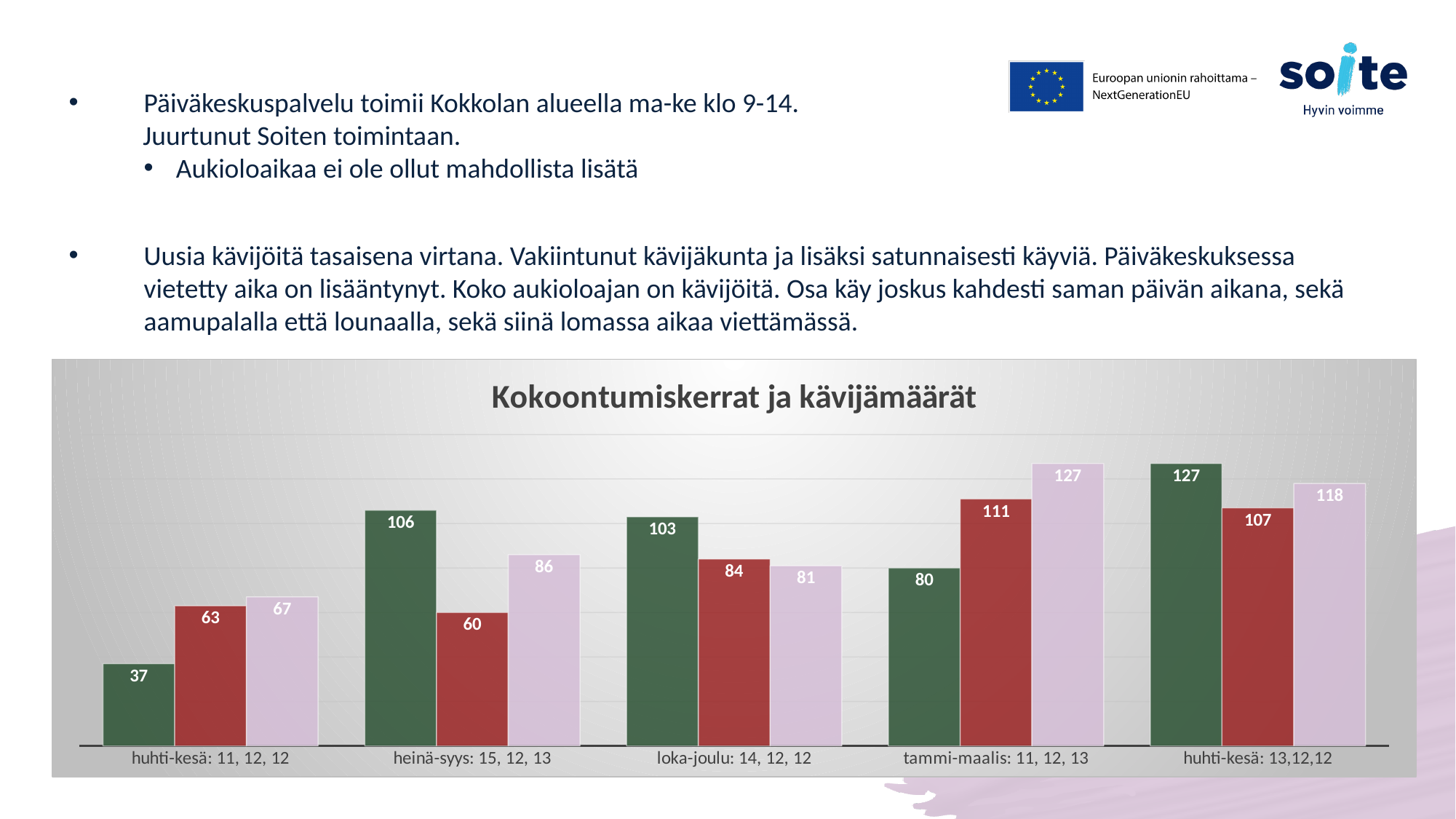
What kind of chart is shown on the slide? bar chart What is the value of the light pink bar for 'tammi-maalis: 11, 12, 13'? 127 What is the value of the red bar for 'heinä-syys: 15, 12, 13'? 60 What is the value of the green bar for 'huhti-kesä: 11, 12, 12'? 37 Do the green bar values rise or fall from 'tammi-maalis: 11, 12, 13' to 'huhti-kesä: 13,12,12'? rise Which category has the lowest green bar? huhti-kesä: 11, 12, 12 Which is larger for 'loka-joulu: 14, 12, 12', the green bar or the red bar? the green bar What is the difference between the green bar and the red bar for 'heinä-syys: 15, 12, 13'? 46 What is the value of the red bar for 'huhti-kesä: 13,12,12'? 107 What is the title of the chart? Kokoontumiskerrat ja kävijämäärät How many categories are shown on the x axis of the chart? 5 Which category has the highest light pink bar? tammi-maalis: 11, 12, 13